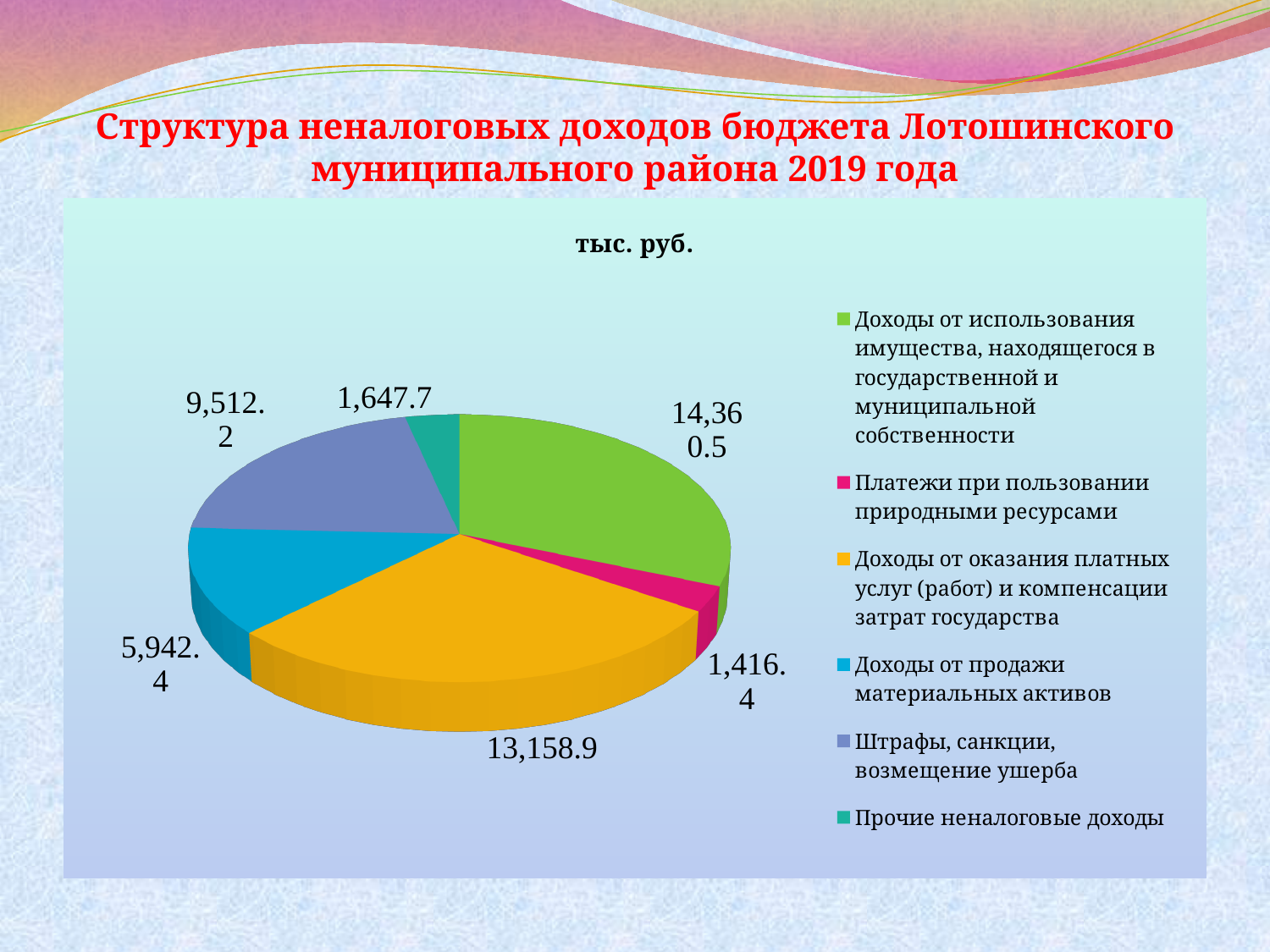
What colour is the slice for "Доходы от продажи материальных активов"? blue Which category has the smallest slice of the pie? Платежи при пользовании природными ресурсами What is the difference between the values for "Штрафы, санкции, возмещение ущерба" and "Доходы от продажи материальных активов"? 3,569.8 Which is larger: the value for "Прочие неналоговые доходы" or the value for "Платежи при пользовании природными ресурсами"? Прочие неналоговые доходы What is the value for "Доходы от оказания платных услуг (работ) и компенсации затрат государства"? 13,158.9 What is the title of the chart? тыс. руб. What is the value for "Штрафы, санкции, возмещение ущерба"? 9,512.2 How many slices does the pie chart have? 6 Which category has the largest slice of the pie? Доходы от использования имущества, находящегося в государственной и муниципальной собственности What kind of chart is shown on the slide? pie chart What is the value for "Доходы от использования имущества, находящегося в государственной и муниципальной собственности"? 14,360.5 What is the value for "Прочие неналоговые доходы"? 1,647.7